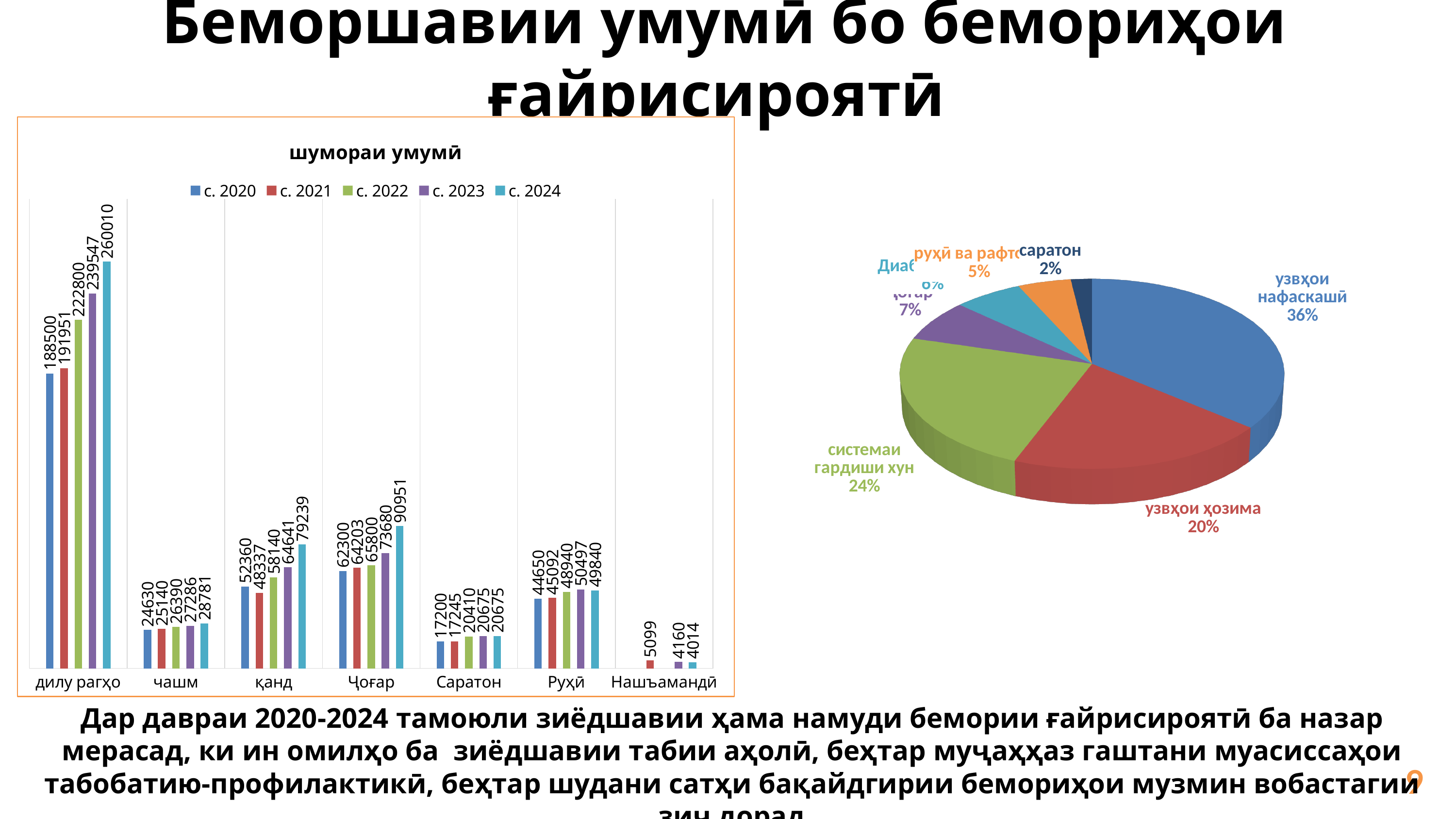
In the bar chart titled 'шумораи умумӣ', what is the difference between the с. 2024 and с. 2020 values for дилу рагҳо? 71510 In the bar chart titled 'шумораи умумӣ', which category has the highest value in с. 2024? дилу рагҳо In the bar chart titled 'шумораи умумӣ', what is the value for Ҷоғар in с. 2020? 62300 In the pie chart on the right, what share does узвҳои нафаскашӣ have? 36% In the bar chart titled 'шумораи умумӣ', what is the value for қанд in с. 2021? 48337 In the pie chart on the right, what share does системаи гардиши хун have? 24% What kind of chart is the chart on the right side of the slide? pie chart In the bar chart titled 'шумораи умумӣ', how many series does the legend list? 5 In the bar chart titled 'шумораи умумӣ', do the values for чашм rise or fall from с. 2020 to с. 2024? rise In the bar chart titled 'шумораи умумӣ', how many categories are shown on the x axis? 7 In the bar chart titled 'шумораи умумӣ', which is larger for Руҳӣ: the с. 2023 value or the с. 2024 value? с. 2023 In the bar chart titled 'шумораи умумӣ', what is the value for дилу рагҳо in с. 2024? 260010